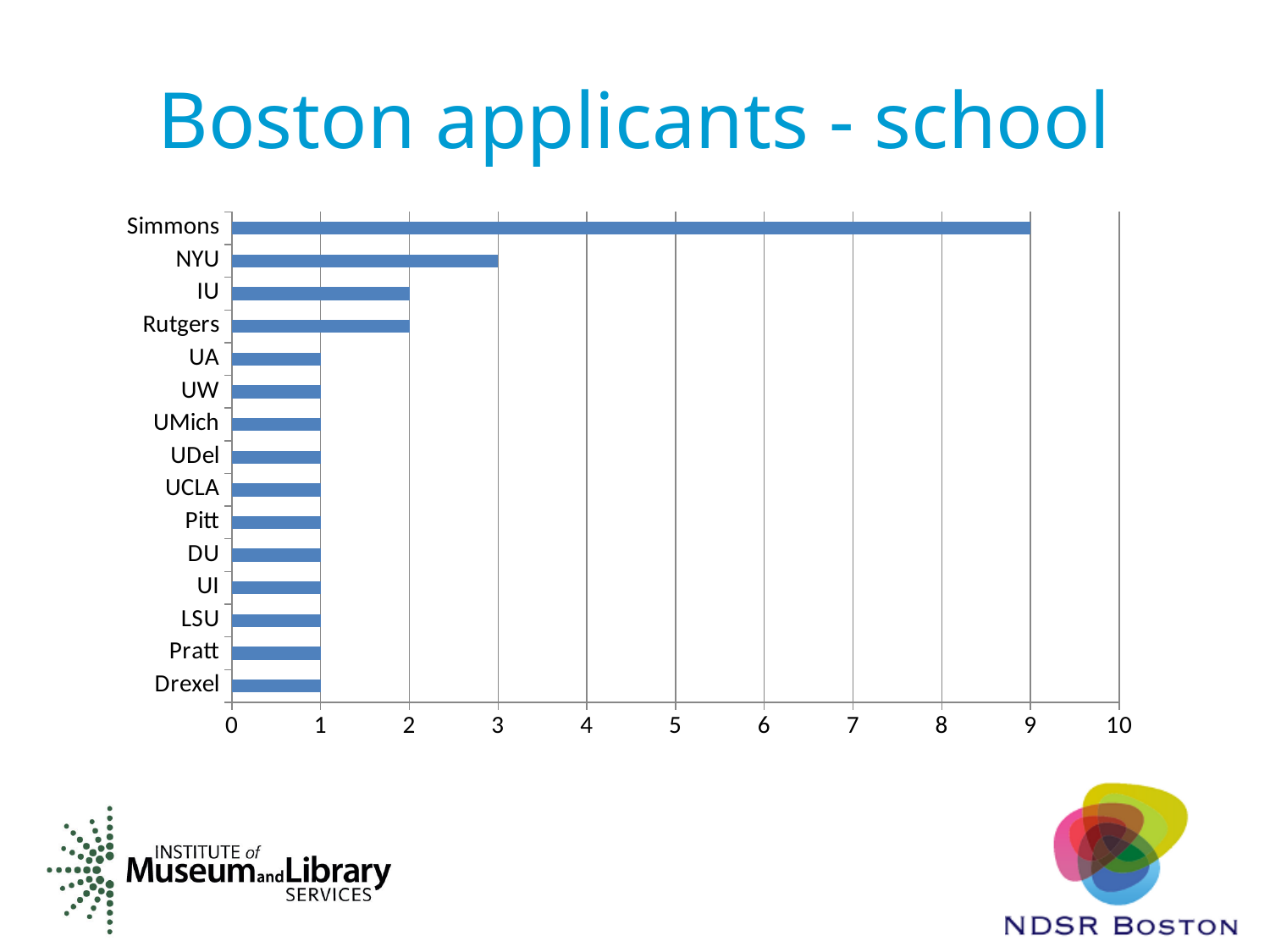
How many schools are shown on the chart? 15 Is the value for Simmons greater or less than 5? greater What is the value for NYU? 3 Which school has the highest value? Simmons What is the difference between the values for Simmons and NYU? 6 What kind of chart is shown on the slide? Bar chart What is the value for Rutgers? 2 What is the value for Simmons? 9 What is the title of the slide? Boston applicants - school What is the difference between the values for NYU and IU? 1 What is the value for Drexel? 1 Which is larger, the value for NYU or the value for Rutgers? NYU